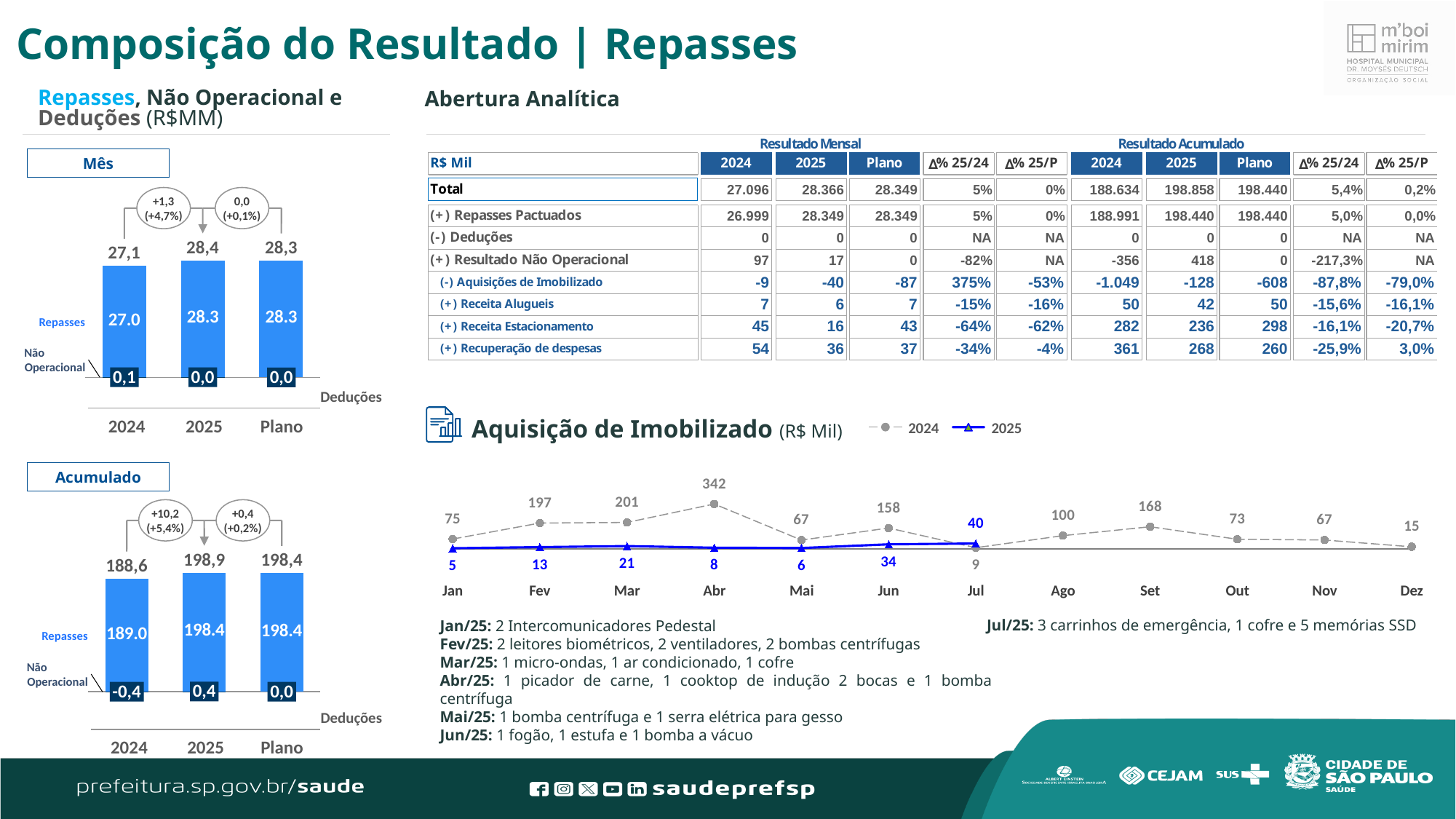
In the 'Aquisição de Imobilizado' line chart, which month has the lowest 2025 value? Jan In the 'Aquisição de Imobilizado' line chart, which month has the highest 2024 value? Abr In the 'Aquisição de Imobilizado' line chart, what is the 2025 value for Jul? 40 In the 'Mês' bar chart, what is the total shown above the 2024 bar? 27,1 In the 'Aquisição de Imobilizado' line chart, what is the 2024 value for Abr? 342 In the 'Aquisição de Imobilizado' line chart, what is the difference between the 2024 and 2025 values for Fev? 184 In the 'Aquisição de Imobilizado' line chart, which is larger for Jul: the 2024 value or the 2025 value? 2025 How many series does the legend of the 'Aquisição de Imobilizado' line chart list? 2 How many months are shown on the x axis of the 'Aquisição de Imobilizado' line chart? 12 In the 'Acumulado' bar chart, what is the Não Operacional value for 2024? -0,4 What kind of chart is the 'Acumulado' chart on the left of the slide? Bar chart In the 'Mês' bar chart, what is the Repasses value for 2025? 28.3